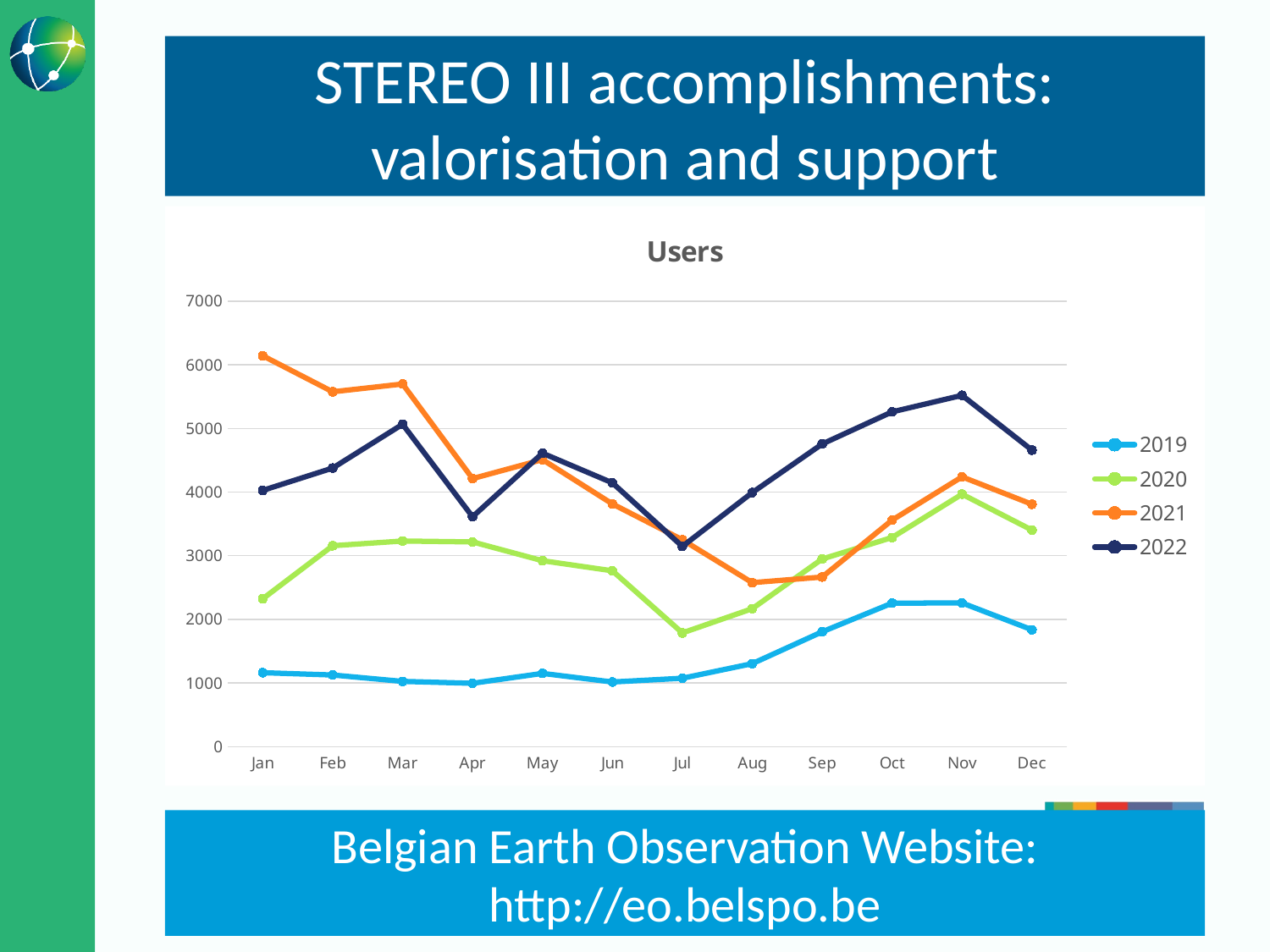
What kind of chart is shown on the slide? line chart What is the title of the chart? Users In which month does the 2022 series reach its lowest value? Jul Does the 2021 series rise or fall from Jan to Aug? fall Is the value for 2021 in Jan greater or less than 6000? greater Is the value for 2020 in Jul greater or less than 2000? less Is the value for 2022 in Nov greater or less than 5000? greater How many months are shown along the x axis? 12 In which month does the 2021 series reach its highest value? Jan Which series has the larger value in Jan, 2021 or 2022? 2021 In which month does the 2020 series reach its highest value? Nov How many series does the legend list? 4